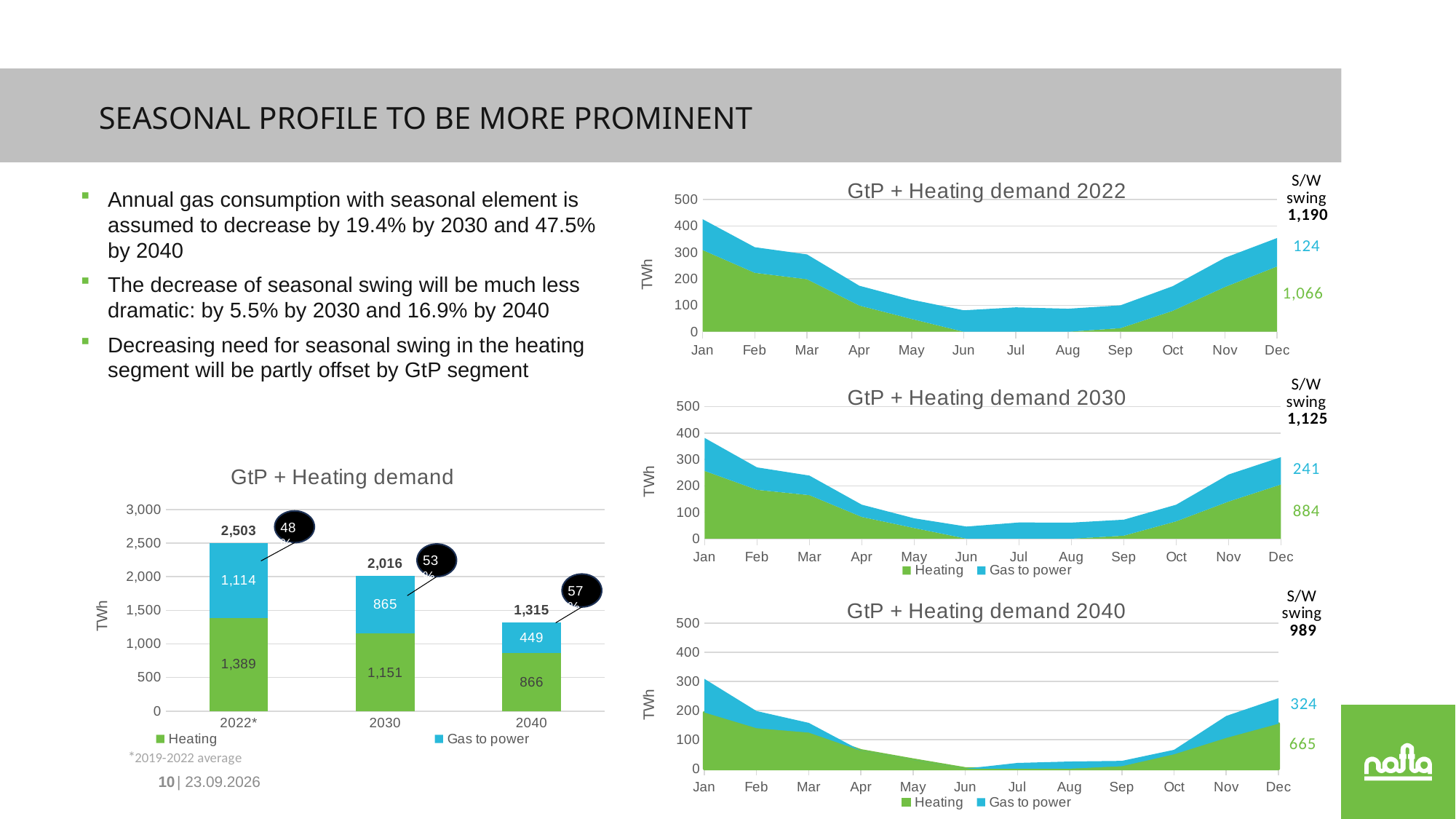
In the area chart titled 'GtP + Heating demand 2040', is the total value for Jan greater or less than 200? greater In the bar chart titled 'GtP + Heating demand', what is the Gas to power value for 2040? 449 How many months are shown on the x axis of the area chart titled 'GtP + Heating demand 2030'? 12 In the bar chart titled 'GtP + Heating demand', which year has the highest total demand? 2022* In the bar chart titled 'GtP + Heating demand', what is the total of the stacked bar for 2030? 2,016 How many series does the legend of the bar chart titled 'GtP + Heating demand' list? 2 How many years (categories) are shown in the bar chart titled 'GtP + Heating demand'? 3 What kind of chart is the 'GtP + Heating demand' chart on the bottom left of the slide? Stacked bar chart In the bar chart titled 'GtP + Heating demand', do the total values rise or fall from 2022* to 2040? Fall In the bar chart titled 'GtP + Heating demand', what is the Heating value for 2022*? 1,389 In the bar chart titled 'GtP + Heating demand', what is the difference between the Heating values for 2022* and 2040? 523 What S/W swing value is printed next to the area chart titled 'GtP + Heating demand 2040'? 989